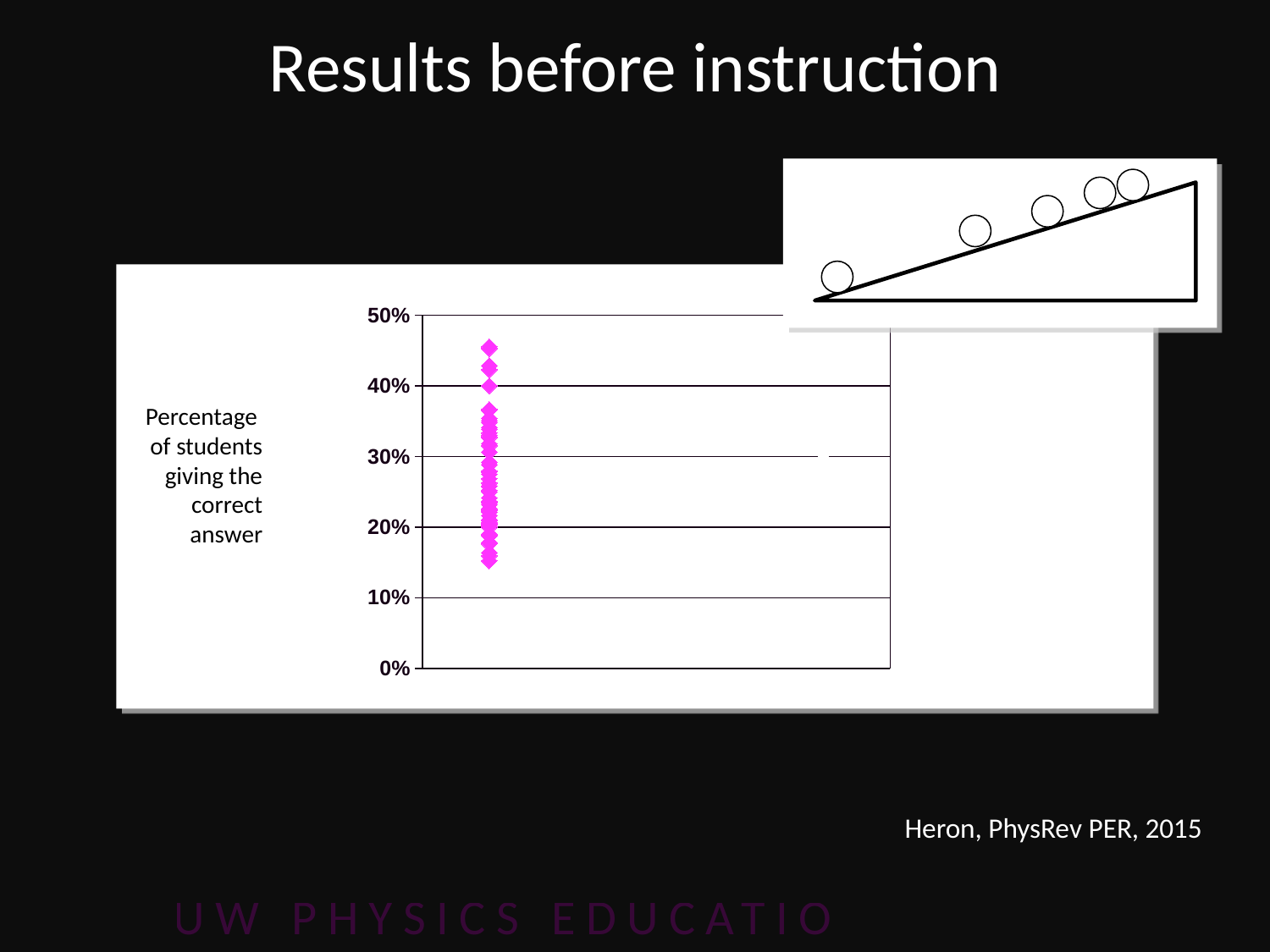
Is the highest plotted point greater or less than 40%? greater What quantity does the vertical axis represent, according to the label on the slide? Percentage of students giving the correct answer What is the maximum value shown on the vertical axis? 50% Are all of the plotted points less than 50%? yes What kind of chart is shown on the slide? scatter chart Are all of the plotted points greater than 10%? yes